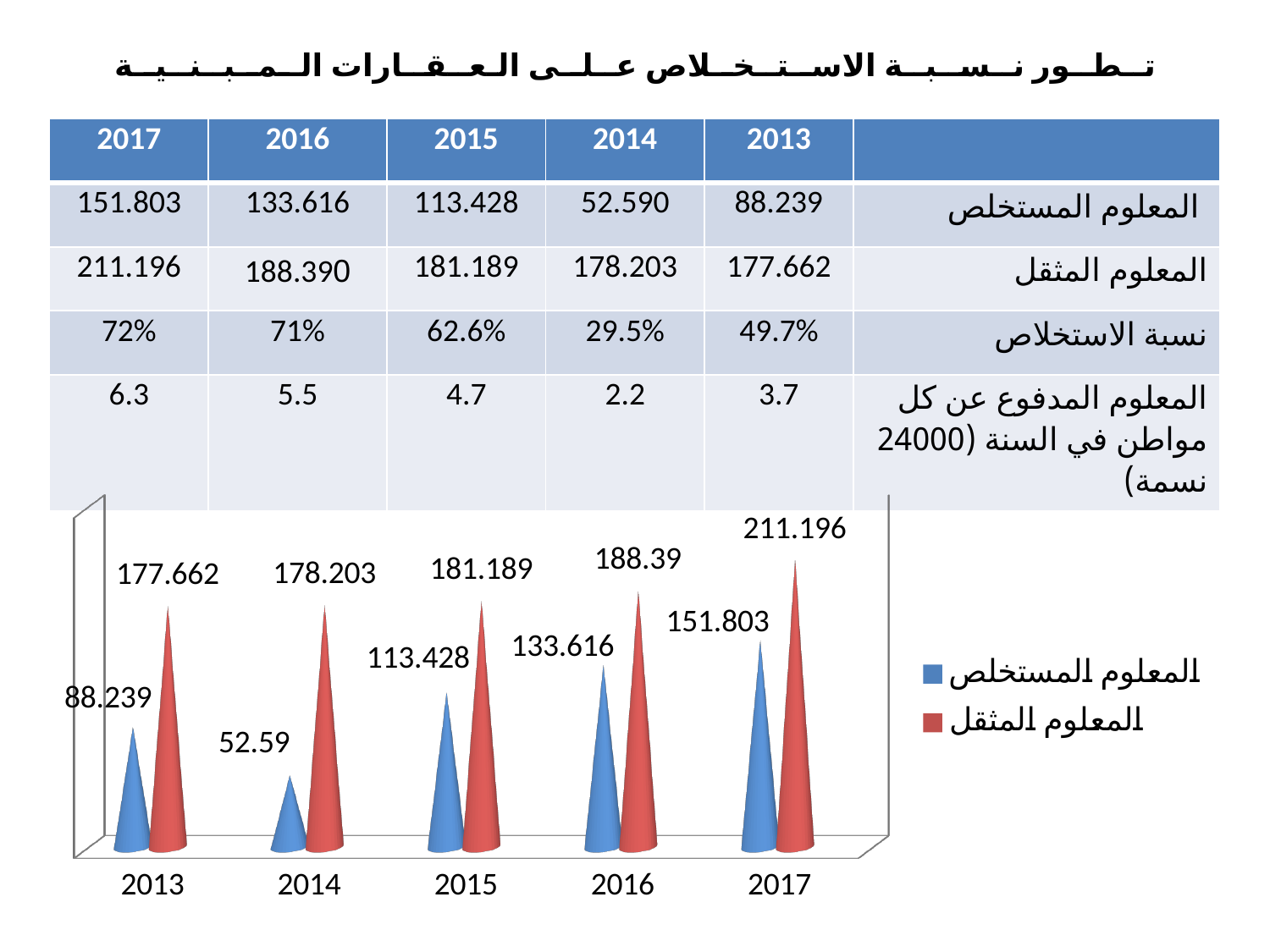
What kind of chart is shown on the slide? bar chart Which year has the highest value for المعلوم المثقل? 2017 Which is larger in 2015, المعلوم المستخلص or المعلوم المثقل? المعلوم المثقل How many years are shown on the chart's x axis? 5 What is the difference between المعلوم المثقل and المعلوم المستخلص in 2017? 59.393 What is the value of المعلوم المستخلص for 2014 on the chart? 52.59 What is the difference between المعلوم المثقل and المعلوم المستخلص in 2013? 89.423 What is the value of المعلوم المستخلص for 2016 on the chart? 133.616 Does المعلوم المثقل rise or fall from 2013 to 2017? rise Which year has the lowest value for المعلوم المستخلص? 2014 How many series does the chart legend list? 2 What is the value of المعلوم المثقل for 2017 on the chart? 211.196